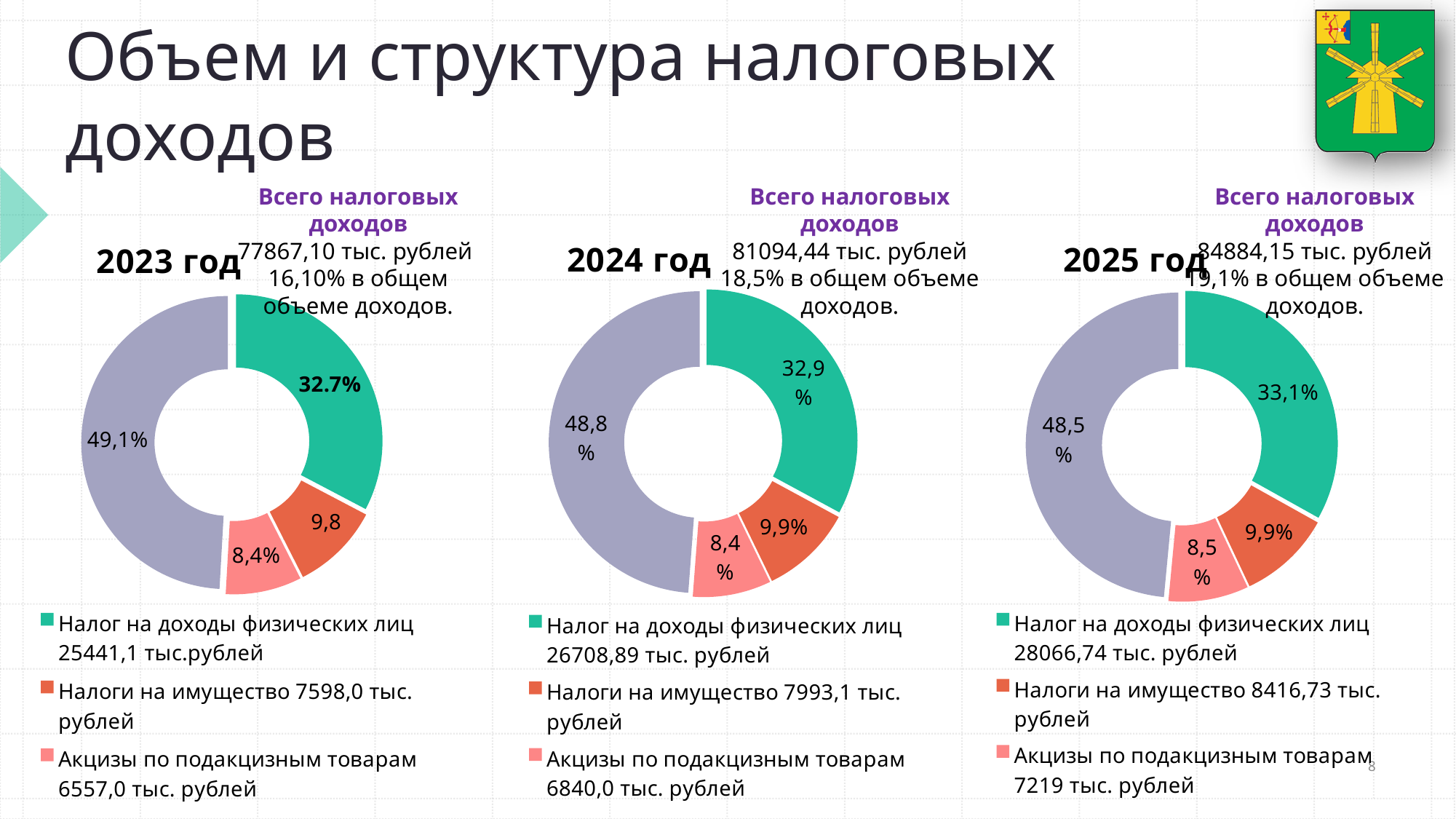
According to the legend of the 2024 год chart, what is the amount of Налог на доходы физических лиц? 26708,89 тыс. рублей In the 2024 год chart, what share is labelled on the grey slice? 48,8% How many slices does the 2024 год chart have? 4 In the 2023 год chart, which is larger: the share of Налоги на имущество or the share of Акцизы по подакцизным товарам? Налоги на имущество In the 2025 год chart, what share is labelled on the pink slice (Акцизы по подакцизным товарам)? 8,5% How many entries does the legend of the 2025 год chart list? 3 In the 2024 год chart, which slice has the smallest share? Акцизы по подакцизным товарам (8,4%) In the 2025 год chart, what is the difference between the share of Налог на доходы физических лиц and the share of Налоги на имущество? 23,2% What kind of chart is used for the 2023 год chart? Doughnut (pie) chart In the 2023 год chart, what share is labelled on the green slice (Налог на доходы физических лиц)? 32.7% In the 2025 год chart, which slice has the largest share? The grey slice (48,5%) What total tax revenue (Всего налоговых доходов) is stated above the 2025 год chart? 84884,15 тыс. рублей